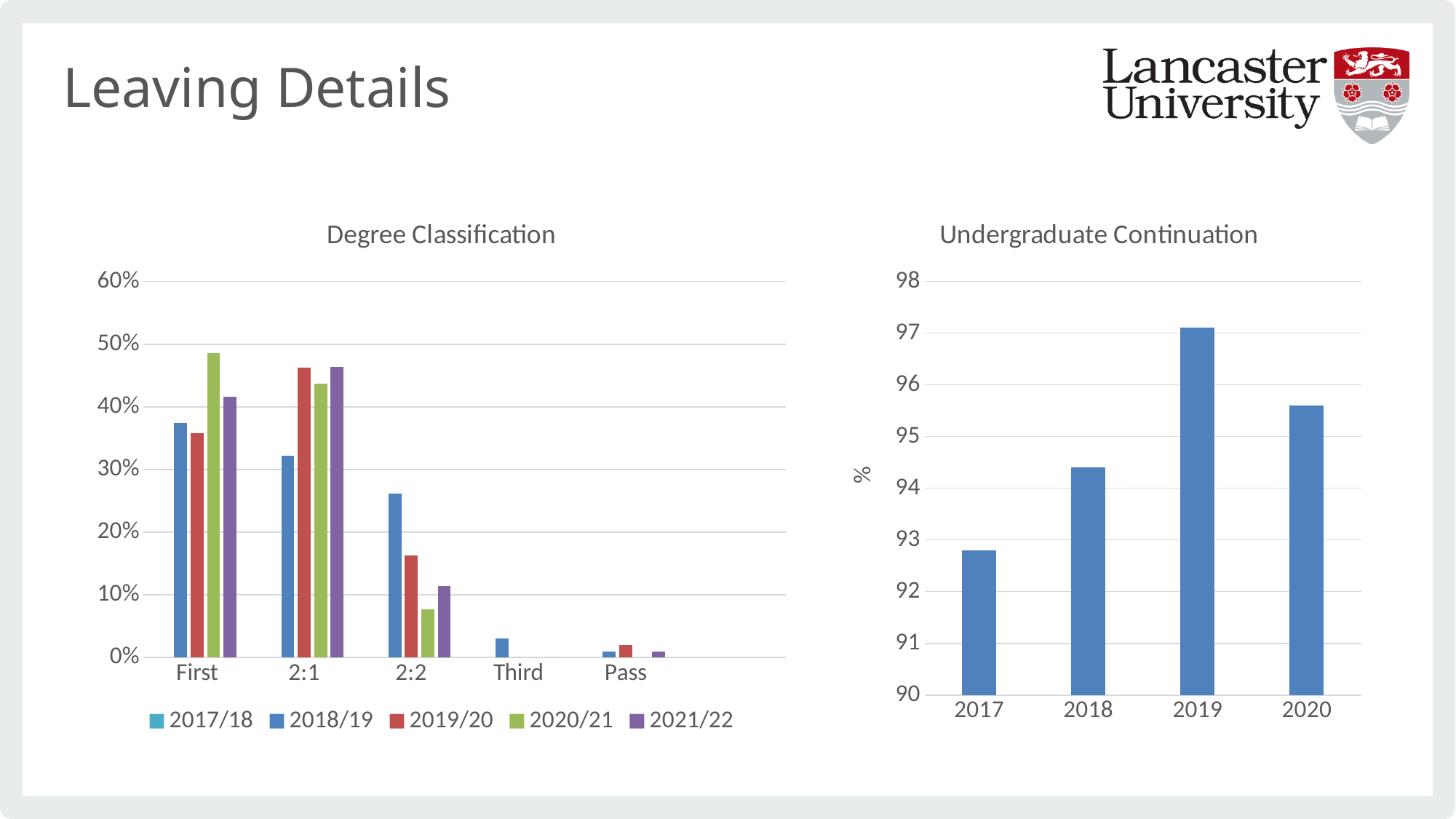
In the Undergraduate Continuation chart, is the value for 2019 greater or less than 96? greater In the Degree Classification chart, for 2:2, which is larger, the 2018/19 bar or the 2019/20 bar? 2018/19 In the Degree Classification chart, how many degree classification categories are shown on the x axis? 5 In the Undergraduate Continuation chart, is the value for 2017 greater or less than 93? less In the Degree Classification chart, how many series does the legend list? 5 In the Degree Classification chart, which series has the highest bar for First? 2020/21 What kind of chart is the Undergraduate Continuation chart? bar chart In the Undergraduate Continuation chart, which year has the lowest value? 2017 In the Undergraduate Continuation chart, do the values rise or fall from 2017 to 2019? rise In the Undergraduate Continuation chart, which is larger, the value for 2018 or the value for 2020? 2020 In the Undergraduate Continuation chart, which year has the highest value? 2019 In the Degree Classification chart, is the 2020/21 value for First greater or less than 40%? greater